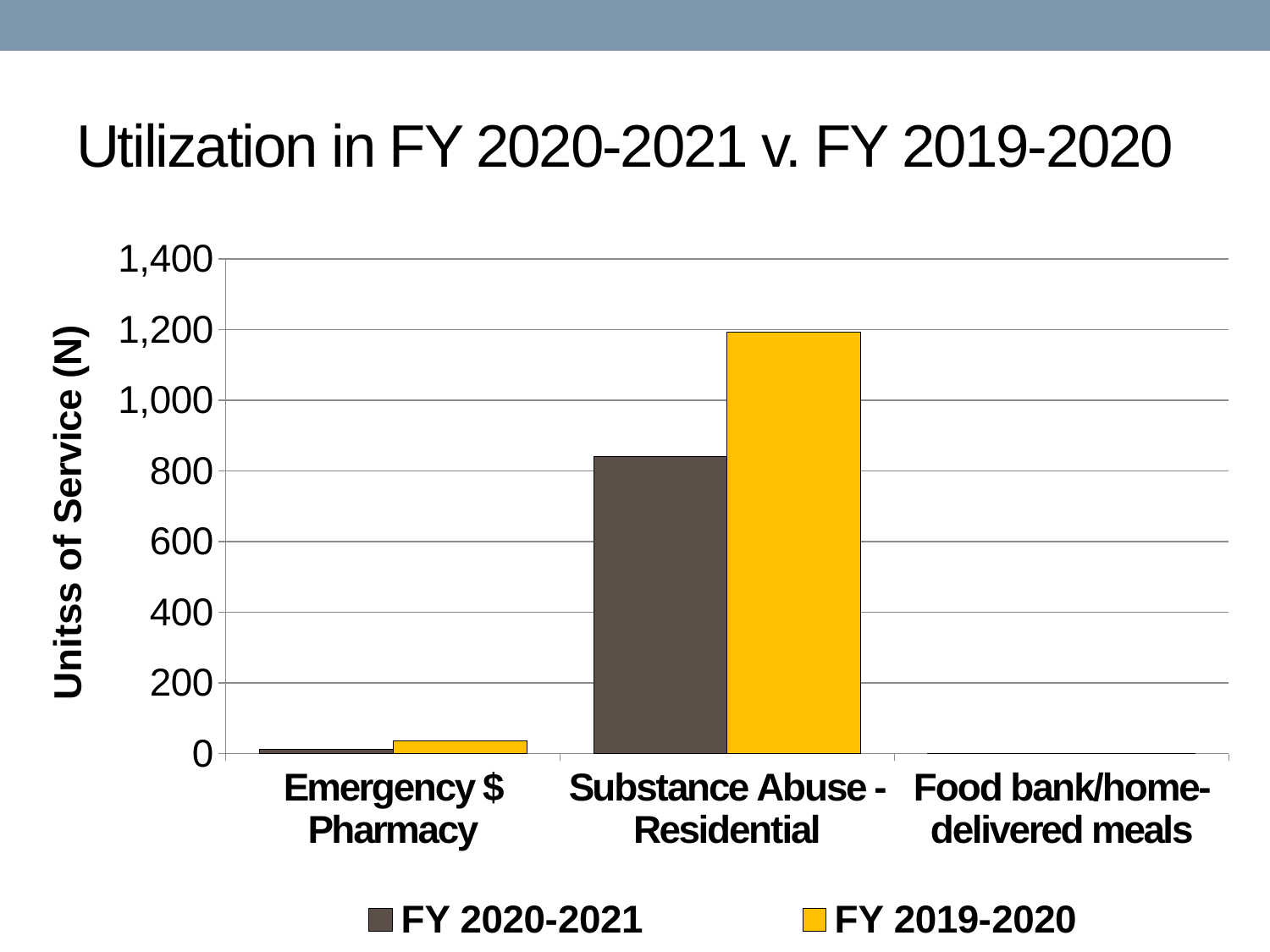
How many series does the legend list? 2 What kind of chart is shown on the slide? Bar chart Which category has the highest value for FY 2019-2020? Substance Abuse - Residential Which category has the highest value for FY 2020-2021? Substance Abuse - Residential What is the title of the chart? Utilization in FY 2020-2021 v. FY 2019-2020 Is the FY 2020-2021 value for Substance Abuse - Residential greater or less than 1,000? less Is the FY 2020-2021 value for Substance Abuse - Residential greater or less than 600? greater For Substance Abuse - Residential, which series is larger: FY 2020-2021 or FY 2019-2020? FY 2019-2020 How many categories are shown on the x axis? 3 What is the label on the y axis? Unitss of Service (N) Is the FY 2019-2020 value for Substance Abuse - Residential greater or less than 1,000? greater